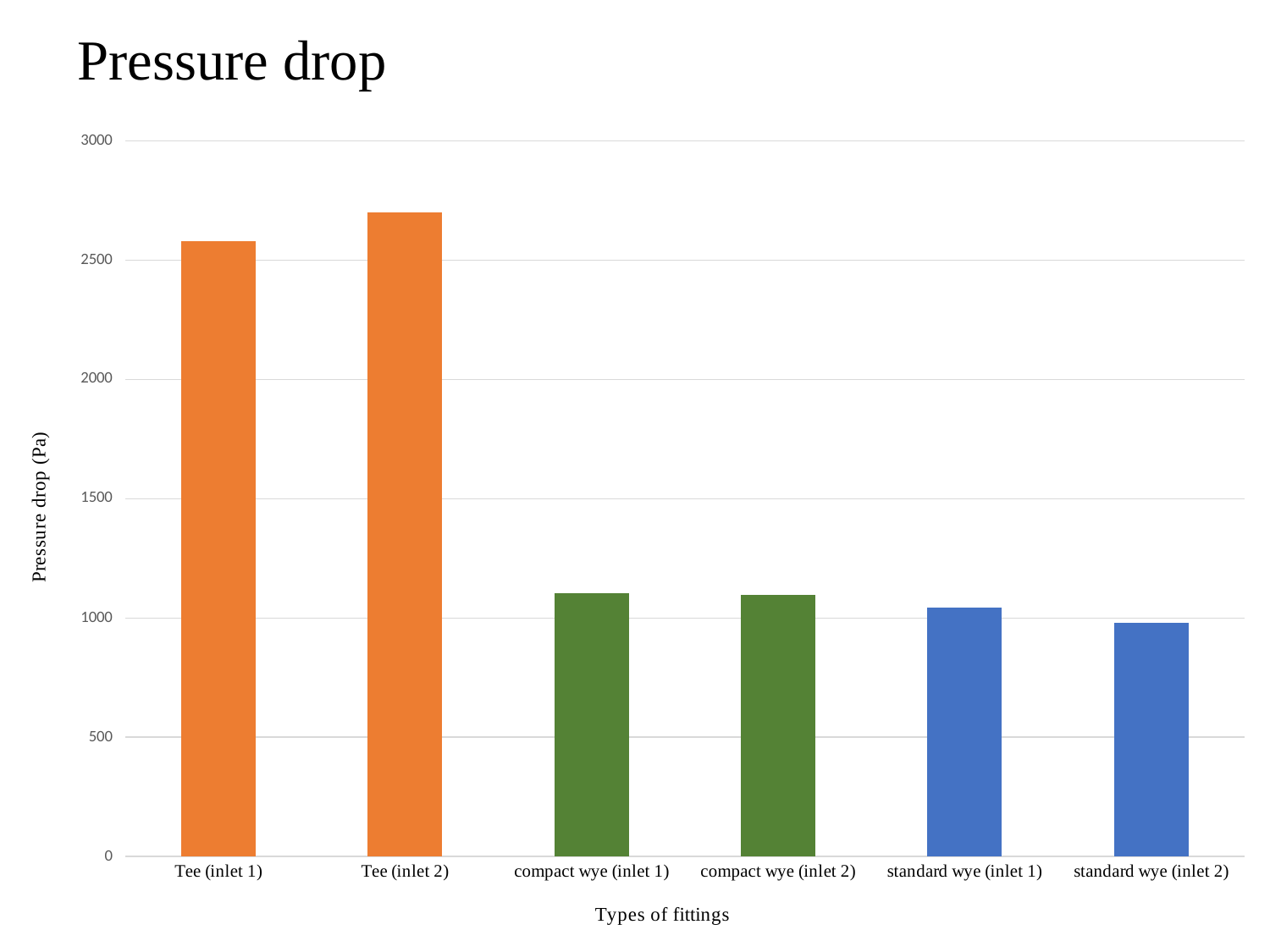
What colour are the bars for the standard wye fittings? Blue Is the pressure drop for compact wye (inlet 1) greater or less than 1000? greater How many types of fittings are plotted on the x axis? 6 What is the label of the y axis? Pressure drop (Pa) Is the pressure drop for Tee (inlet 1) greater or less than 2500? greater Which has a larger pressure drop, Tee (inlet 2) or Tee (inlet 1)? Tee (inlet 2) Which type of fitting has the lowest pressure drop? standard wye (inlet 2) What kind of chart is shown on the slide? Bar chart Which type of fitting has the highest pressure drop? Tee (inlet 2) Is the pressure drop for Tee (inlet 2) greater or less than 3000? less Which has a larger pressure drop, Tee (inlet 1) or compact wye (inlet 1)? Tee (inlet 1)